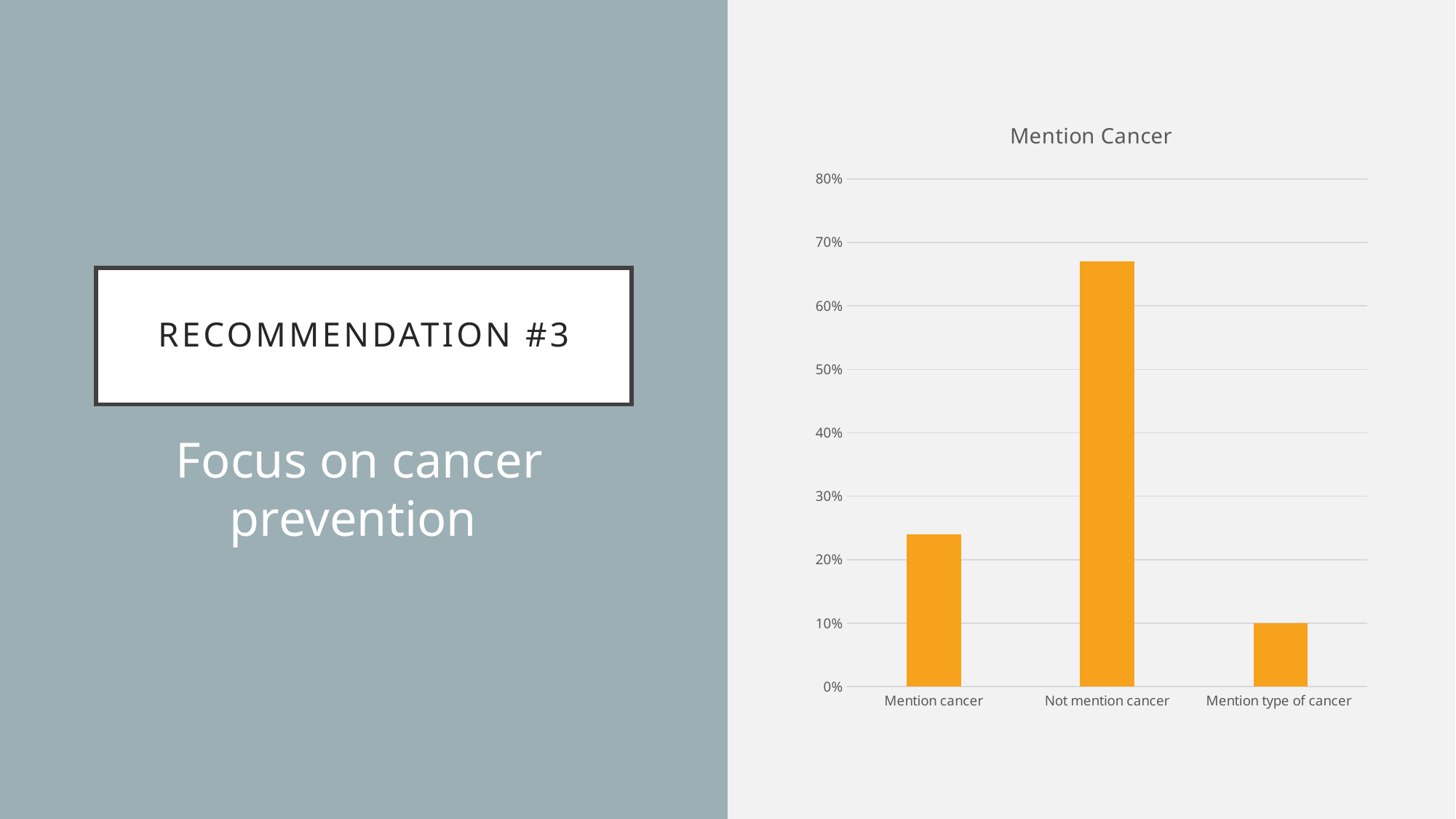
Is the value for Mention cancer greater or less than 30%? less Is the value for Mention cancer greater or less than 20%? greater Which category has the lowest value in the chart? Mention type of cancer Is the value for Not mention cancer greater or less than 60%? greater How many categories are shown on the x axis of the chart? 3 Which is larger, the value for Mention cancer or the value for Not mention cancer? Not mention cancer What colour are the bars in the chart? orange What is the title of the chart? Mention Cancer What is the value for Mention type of cancer? 10% Which category has the highest value in the chart? Not mention cancer What type of chart is shown on the slide? bar chart